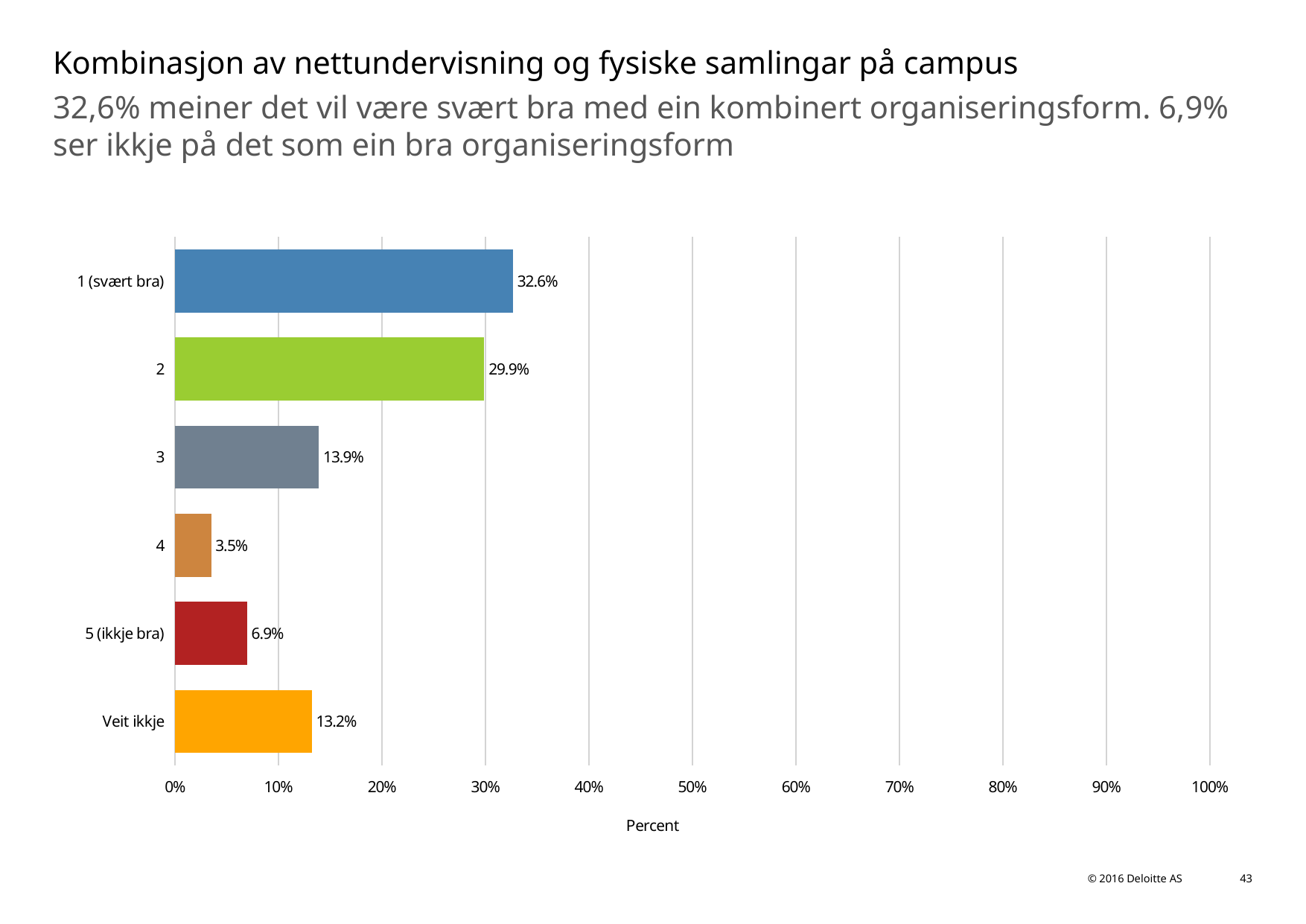
Which category has the lowest value? 4 Which is larger, the value for category 3 or the value for "Veit ikkje"? 3 What is the value for category 4? 3.5% What is the value for "1 (svært bra)"? 32.6% What kind of chart is shown on the slide? bar chart What colour is the bar for "5 (ikkje bra)"? red Which category has the highest value? 1 (svært bra) What is the difference between the values for "1 (svært bra)" and "5 (ikkje bra)"? 25.7% What is the value for "Veit ikkje"? 13.2% Is the value for category 2 greater or less than 30%? less What is the label of the horizontal axis? Percent How many categories are shown in the chart? 6